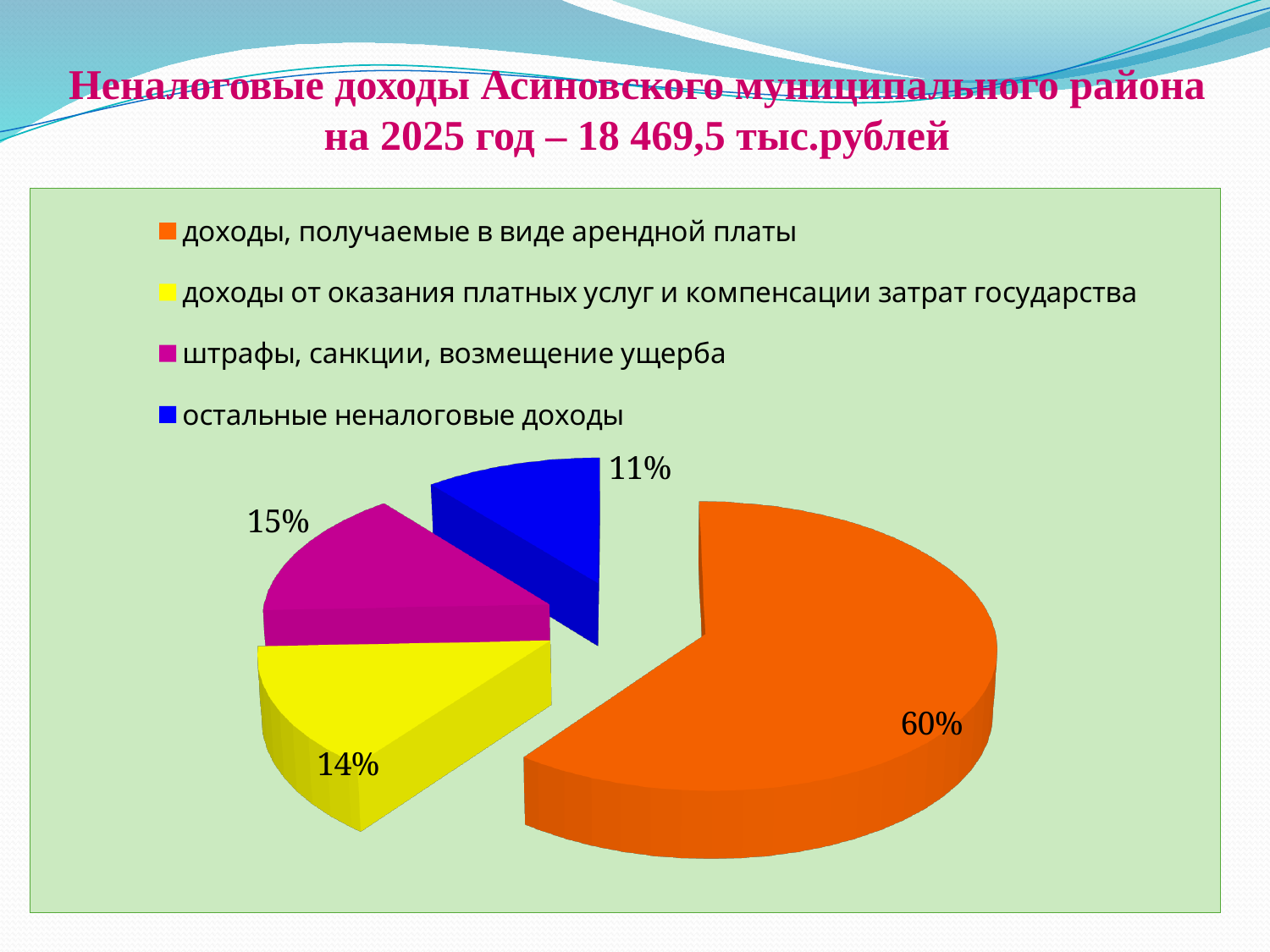
Which category has the largest slice of the pie? доходы, получаемые в виде арендной платы Which is larger: the slice for "штрафы, санкции, возмещение ущерба" or the slice for "остальные неналоговые доходы"? штрафы, санкции, возмещение ущерба What share of the pie does "остальные неналоговые доходы" account for? 11% What colour is the slice for "доходы, получаемые в виде арендной платы"? Orange How many slices does the pie chart have? 4 What share of the pie does "доходы, получаемые в виде арендной платы" account for? 60% What share of the pie does "штрафы, санкции, возмещение ущерба" account for? 15% What total amount of non-tax revenue for 2025 is stated in the slide title? 18 469,5 тыс.рублей What is the difference in percentage points between the slice for "доходы, получаемые в виде арендной платы" and the slice for "остальные неналоговые доходы"? 49 percentage points What kind of chart is shown on the slide? Pie chart Which category has the smallest slice of the pie? остальные неналоговые доходы